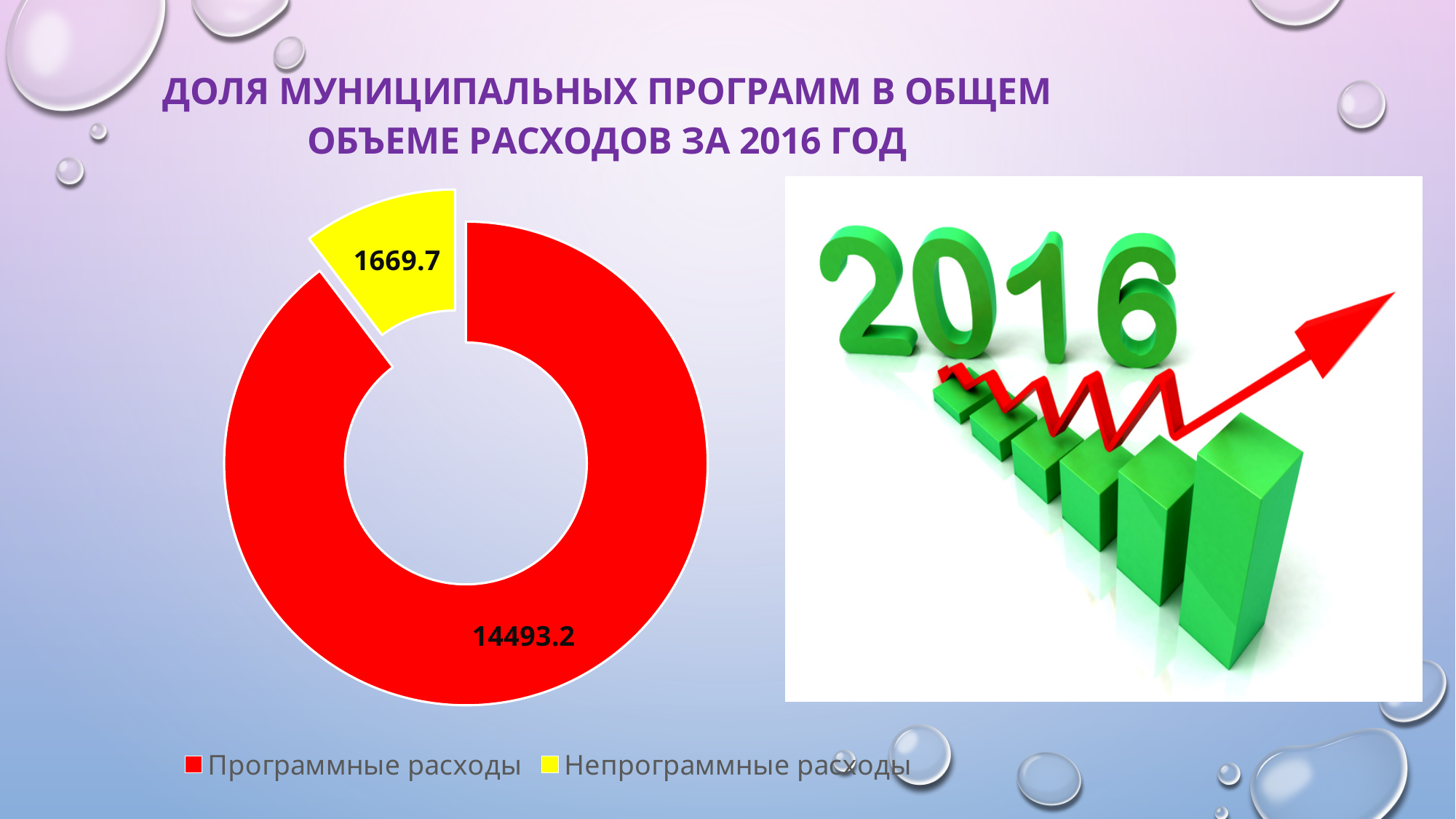
What is the total of the two values shown in the chart? 16162.9 Which is larger: the value for Программные расходы or the value for Непрограммные расходы? Программные расходы What kind of chart is shown on the slide? doughnut chart What is the difference between the values for Программные расходы and Непрограммные расходы? 12823.5 What is the title of the slide containing the chart? Доля муниципальных программ в общем объеме расходов за 2016 год What value is shown for Программные расходы in the doughnut chart? 14493.2 What colour represents Непрограммные расходы in the chart? yellow How many categories does the chart show? 2 Which category has the smallest slice in the chart? Непрограммные расходы Which category has the largest slice in the chart? Программные расходы What value is shown for Непрограммные расходы in the doughnut chart? 1669.7 How many entries does the legend list? 2